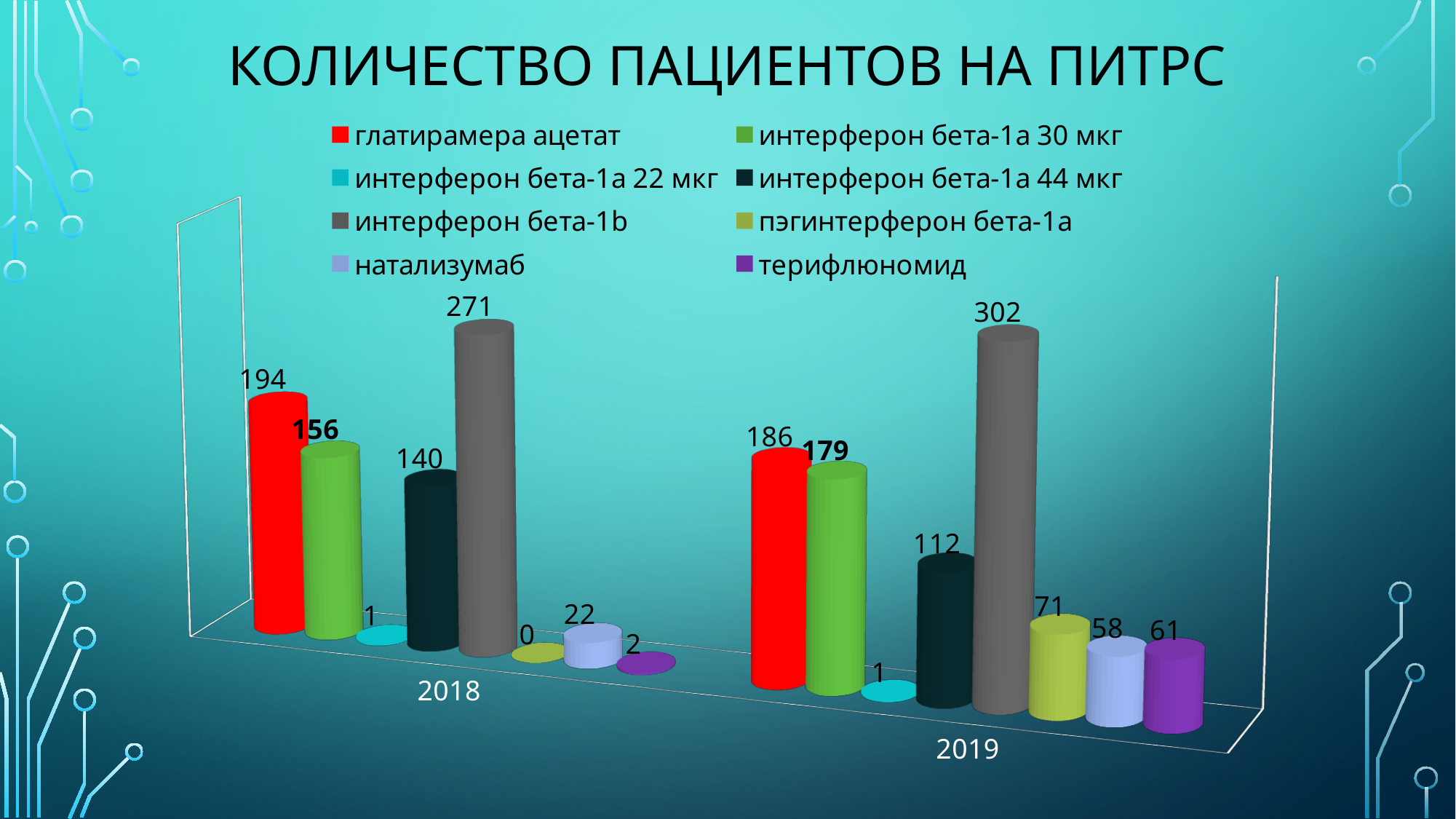
Which is larger in 2019: натализумаб or терифлюномид? терифлюномид What is the difference between the интерферон бета-1b values for 2019 and 2018? 31 Which series has the highest value in 2019? интерферон бета-1b What is the value for глатирамера ацетат in 2019? 186 What is the value for интерферон бета-1b in 2018? 271 What kind of chart is this? bar chart How many categories are shown on the x axis? 2 Which series has the lowest value in 2018? пэгинтерферон бета-1а What is the value for натализумаб in 2018? 22 What is the title of the chart? КОЛИЧЕСТВО ПАЦИЕНТОВ НА ПИТРС How many series does the legend list? 8 What is the value for пэгинтерферон бета-1а in 2019? 71